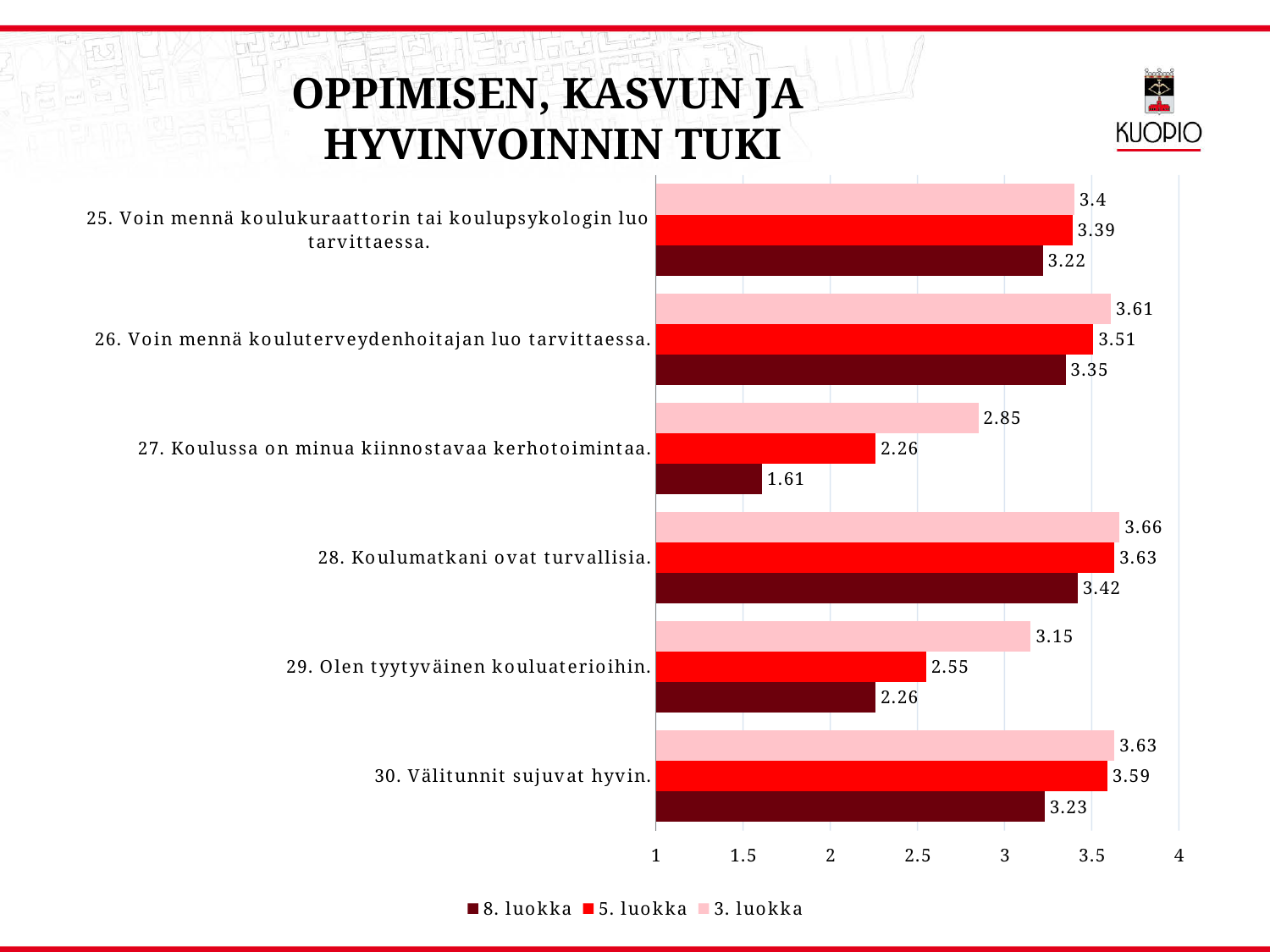
What is the value for 8. luokka on item 27 (Koulussa on minua kiinnostavaa kerhotoimintaa)? 1.61 Which series is shown in the darkest colour in the legend? 8. luokka Which item has the highest value for 3. luokka? 28. Koulumatkani ovat turvallisia. Which item has the lowest value for 8. luokka? 27. Koulussa on minua kiinnostavaa kerhotoimintaa. How many series does the legend list? 3 On item 29 (Olen tyytyväinen kouluaterioihin), which is larger: the 3. luokka value or the 5. luokka value? 3. luokka What is the value for 5. luokka on item 29 (Olen tyytyväinen kouluaterioihin)? 2.55 How many items (categories) are shown on the chart? 6 What is the value for 8. luokka on item 30 (Välitunnit sujuvat hyvin)? 3.23 What is the value for 3. luokka on item 28 (Koulumatkani ovat turvallisia)? 3.66 What kind of chart is shown on the slide? Bar chart What is the difference between the 3. luokka and 8. luokka values on item 27 (Koulussa on minua kiinnostavaa kerhotoimintaa)? 1.24